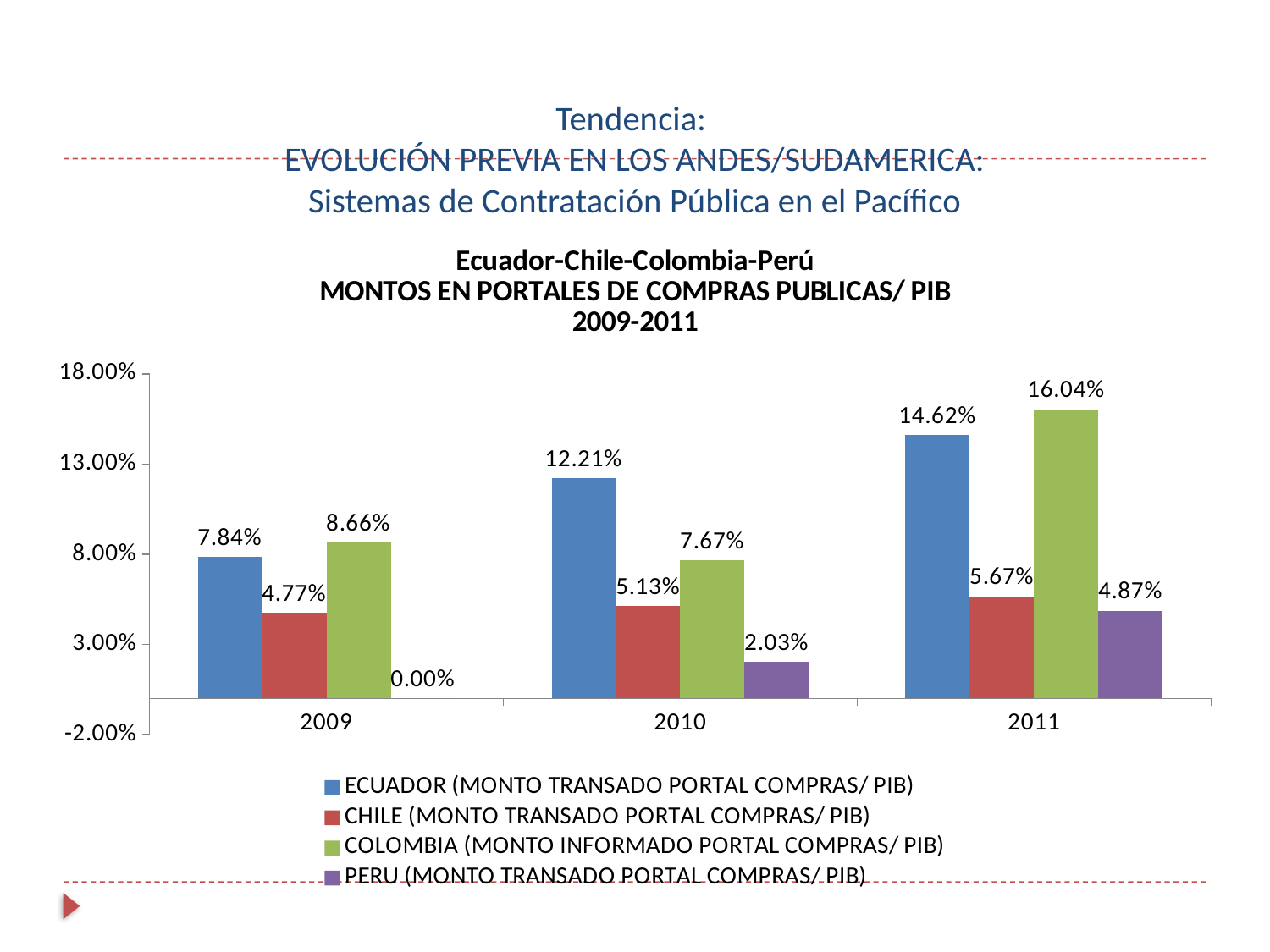
What kind of chart is shown on the slide? Bar chart How many series does the legend list? 4 What is the value for Colombia in 2009? 8.66% Which country has the lowest value in 2009? Peru What is the value for Chile in 2010? 5.13% What is the difference between Colombia's and Ecuador's values in 2011? 1.42% What is the value for Peru in 2010? 2.03% Which is larger in 2010: the value for Ecuador or the value for Colombia? Ecuador Which country has the highest value in 2011? Colombia What is the value for Ecuador in 2011? 14.62% Does the value for Ecuador rise or fall from 2009 to 2011? Rise Which colour represents Chile in the chart? Red